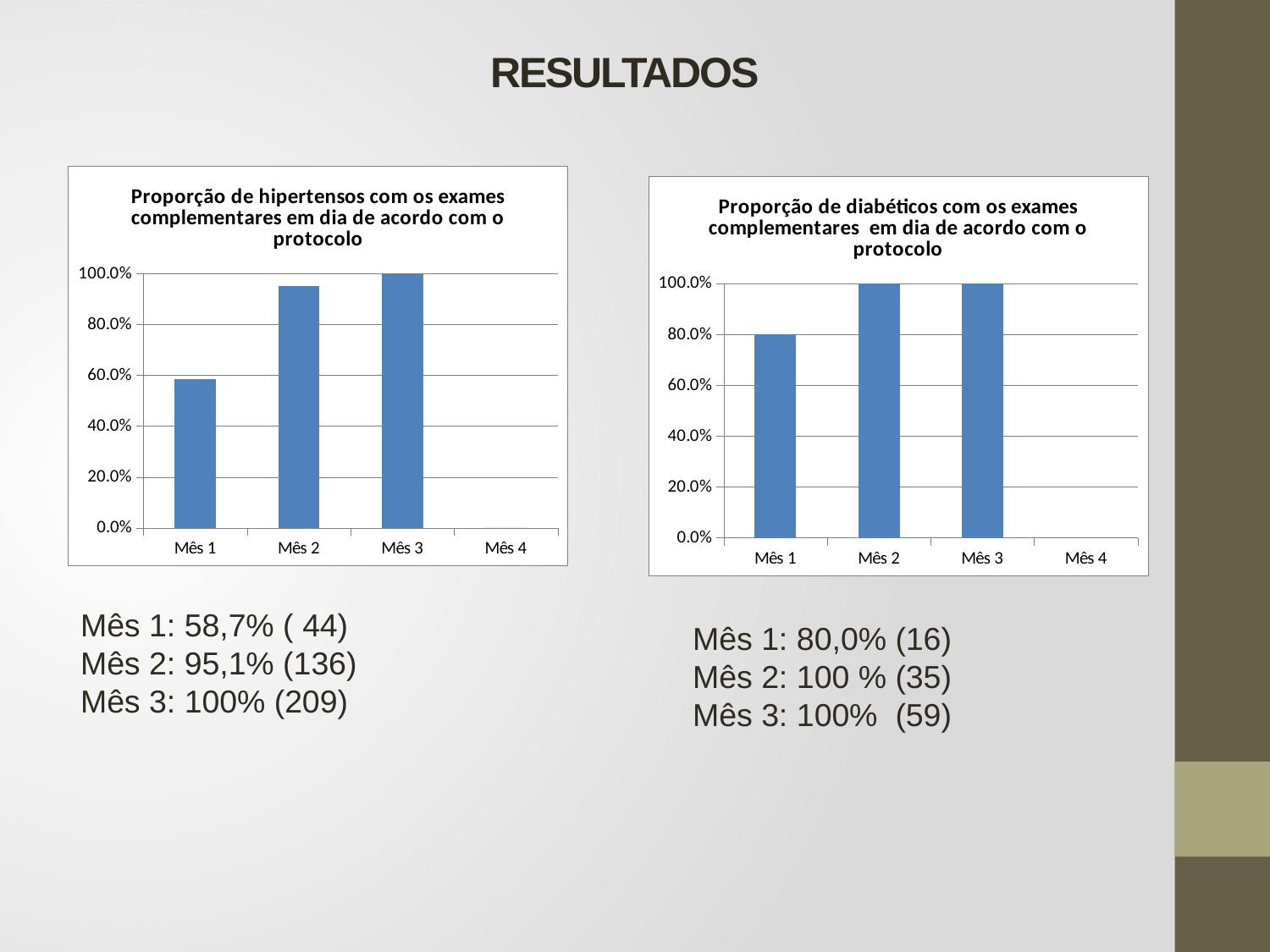
In the left chart (Proporção de hipertensos), which is larger, the value for Mês 1 or Mês 2? Mês 2 In the left chart (Proporção de hipertensos), which month has the highest value? Mês 3 In the right chart (Proporção de diabéticos), what is the difference between the values for Mês 2 and Mês 1? 20,0% In the left chart (Proporção de hipertensos), do the values rise or fall from Mês 1 to Mês 3? Rise In the left chart (Proporção de hipertensos), is the value for Mês 2 greater or less than 80.0%? greater In the right chart (Proporção de diabéticos), what is the value for Mês 1? 80,0% In the left chart (Proporção de hipertensos), is the value for Mês 1 greater or less than 60.0%? less What kind of chart is the right chart (Proporção de diabéticos)? Bar chart In the left chart (Proporção de hipertensos), what is the value for Mês 1? 58,7% In the left chart (Proporção de hipertensos), what is the value for Mês 3? 100%